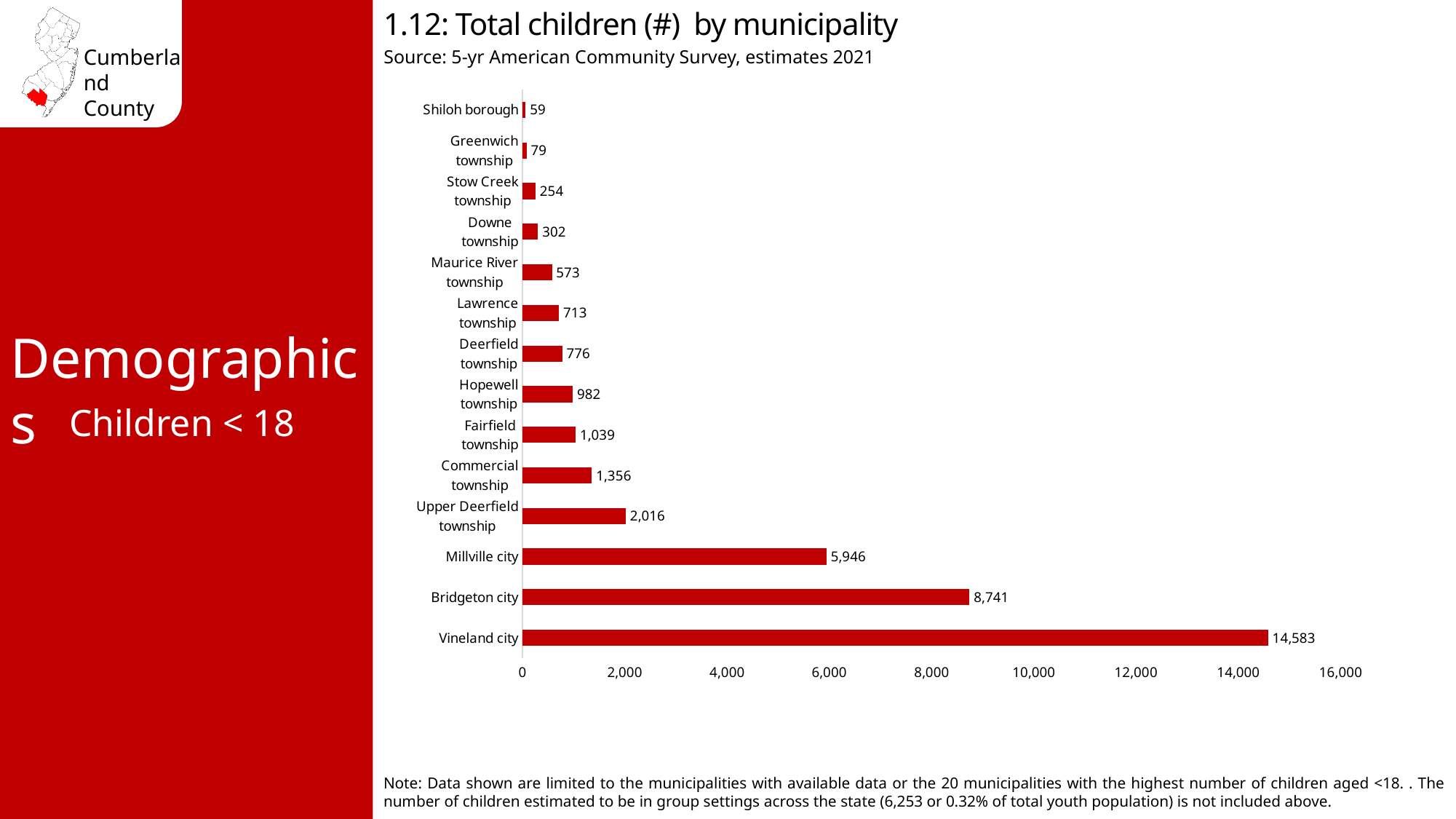
Which municipality has the lowest number of children? Shiloh borough What is the difference in the number of children between Bridgeton city and Millville city? 2,795 What is the title of the chart? 1.12: Total children (#) by municipality What is the total number of children in Hopewell township? 982 What kind of chart is shown on the slide? bar chart What is the total number of children in Vineland city? 14,583 Which has more children, Commercial township or Fairfield township? Commercial township Which municipality has the highest number of children? Vineland city How many municipalities are shown in the chart? 14 What is the difference in the number of children between Lawrence township and Maurice River township? 140 What is the total number of children in Shiloh borough? 59 Is the value for Upper Deerfield township greater or less than 4,000? less